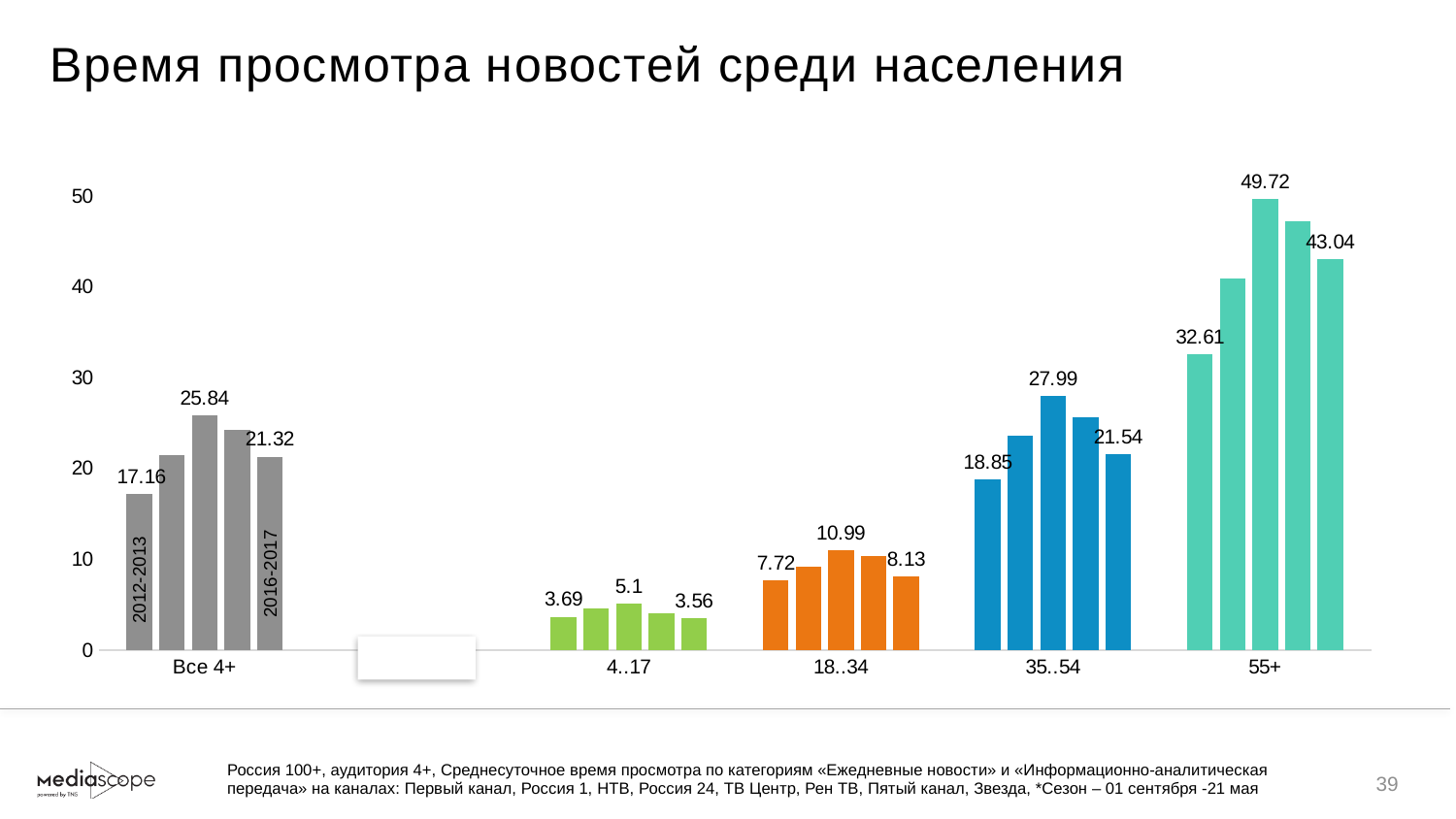
Is the value of the second bar in the 35..54 group greater or less than 20? greater In the Все 4+ group, how much higher is the tallest bar (25.84) than the 2012-2013 bar (17.16)? 8.68 In the 18..34 group, which is larger: the 2012-2013 value or the 2016-2017 value? 2016-2017 In the 55+ group, what is the difference between the tallest bar (49.72) and the 2012-2013 bar (32.61)? 17.11 What is the title of the chart? Время просмотра новостей среди населения What is the lowest labeled value on the chart? 3.56 What is the value of the tallest bar in the 35..54 group? 27.99 What is the value for the 2012-2013 season in the Все 4+ group? 17.16 What kind of chart is shown on the slide? bar chart Which age group has the highest bar on the chart? 55+ What is the value for the 2016-2017 season in the 55+ group? 43.04 Is the value of the fourth bar in the 55+ group greater or less than 40? greater